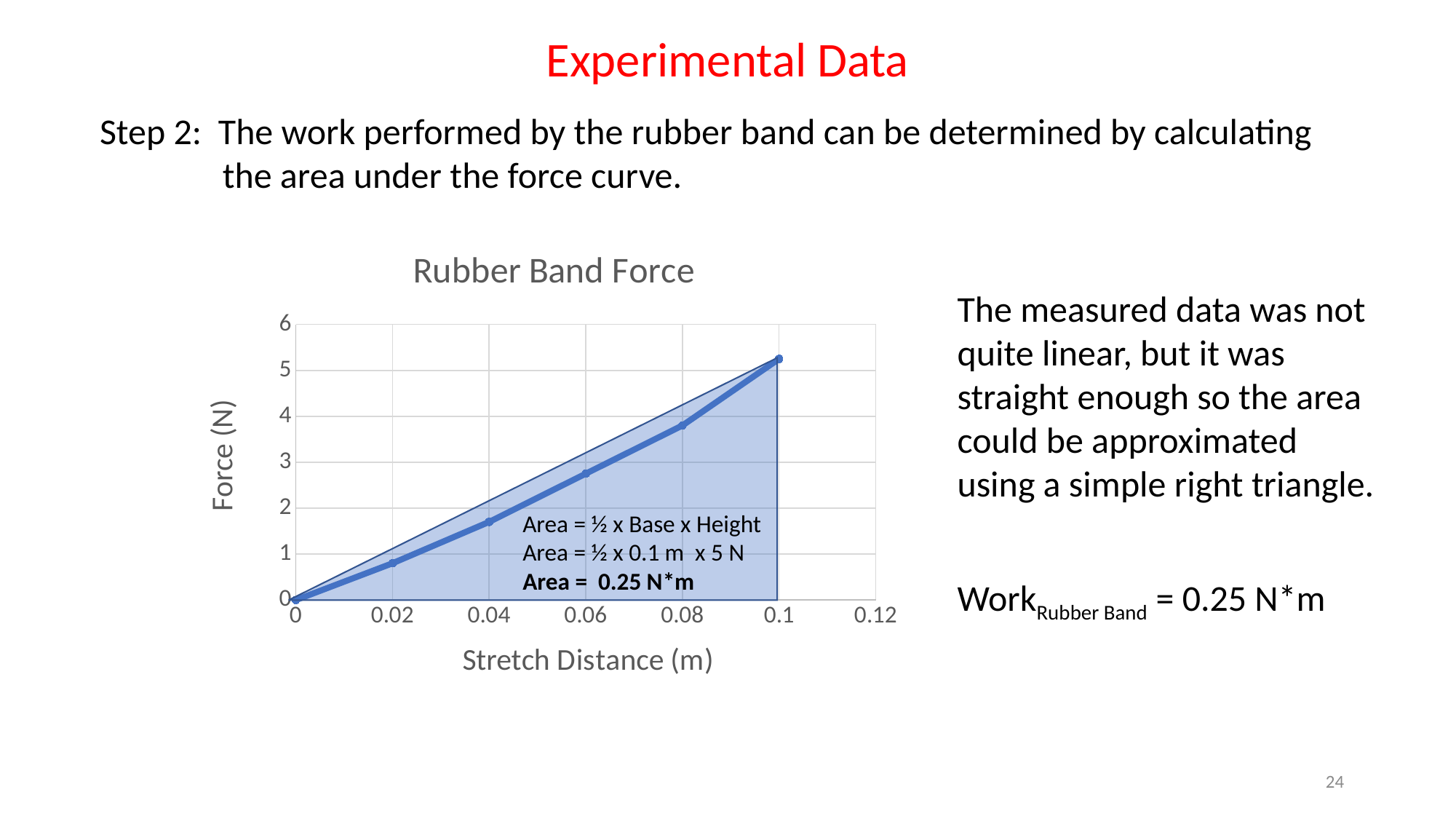
What is the title of the chart? Rubber Band Force Is the force at a stretch distance of 0.1 greater or less than 5? greater Does the force rise or fall as the stretch distance increases along the x axis? rise Is the force at a stretch distance of 0.08 greater or less than 4? less Which has the larger force, a stretch distance of 0.04 or 0.06? 0.06 What kind of chart is shown on the slide? line chart Is the force at a stretch distance of 0.02 greater or less than 1? less At which stretch distance is the force lowest? 0 How many data points are plotted on the line in the chart? 6 What is the label of the vertical axis of the chart? Force (N) At which stretch distance is the force highest? 0.1 What is the force value at a stretch distance of 0? 0